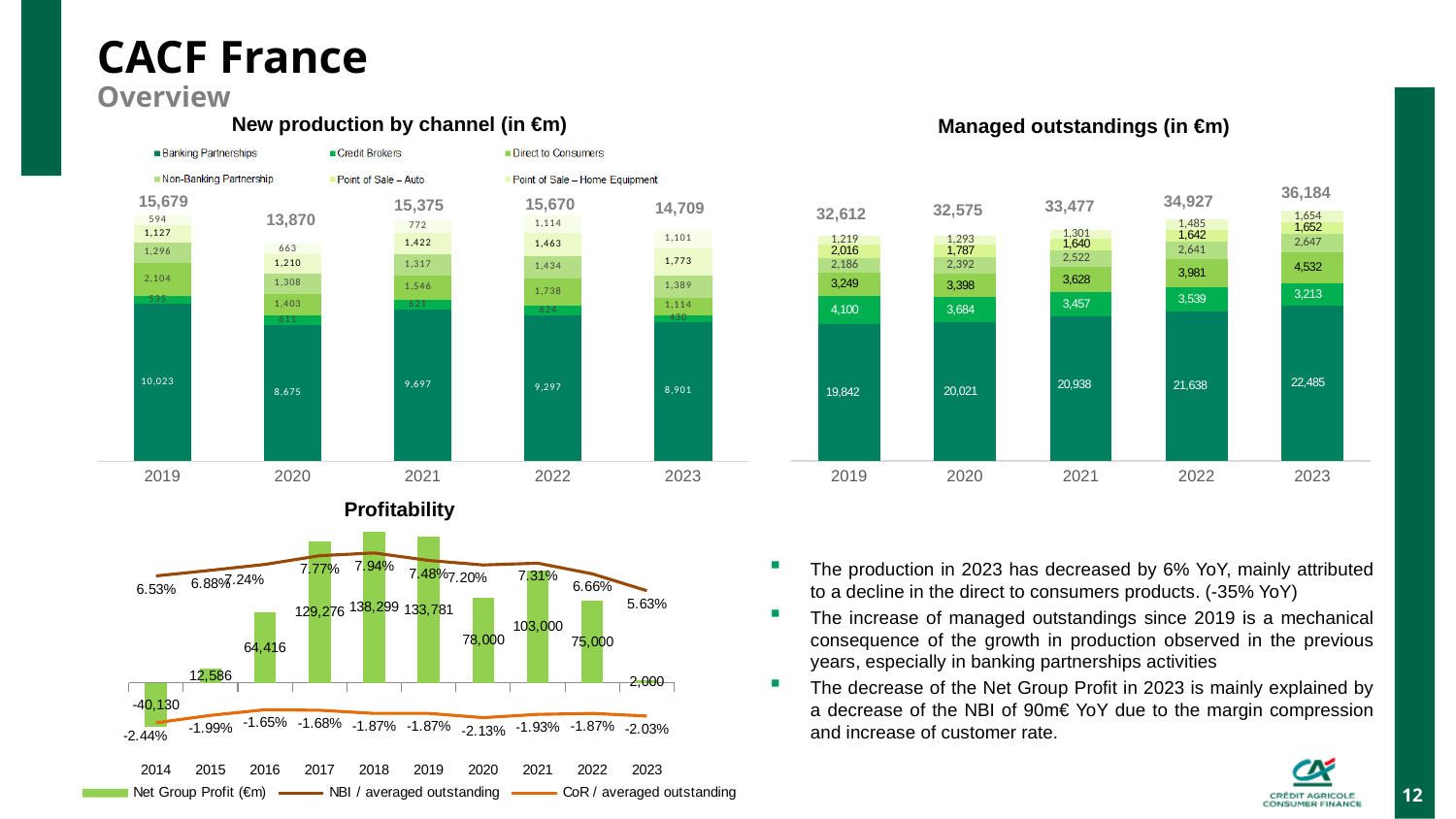
In the 'Profitability' chart, which year has the lowest Net Group Profit? 2014 In the 'New production by channel' chart, what is the total new production for 2019? 15,679 In the 'Managed outstandings' chart, do the totals rise or fall from 2020 to 2023? rise In the 'Managed outstandings' chart, what is the total managed outstandings for 2023? 36,184 In the 'Managed outstandings' chart, what is the difference between the 2023 total and the 2022 total? 1,257 In the 'Profitability' chart, what is the NBI / averaged outstanding value for 2023? 5.63% In the 'Managed outstandings' chart, how many years are shown on the x axis? 5 In the 'Managed outstandings' chart, which year has the highest total? 2023 In the 'Profitability' chart, what is the Net Group Profit for 2018? 138,299 In the 'Profitability' chart, is the Net Group Profit larger in 2021 or in 2022? 2021 In the 'New production by channel' chart, which year has the lowest total new production? 2020 In the 'New production by channel' chart, how many series does the legend list? 6